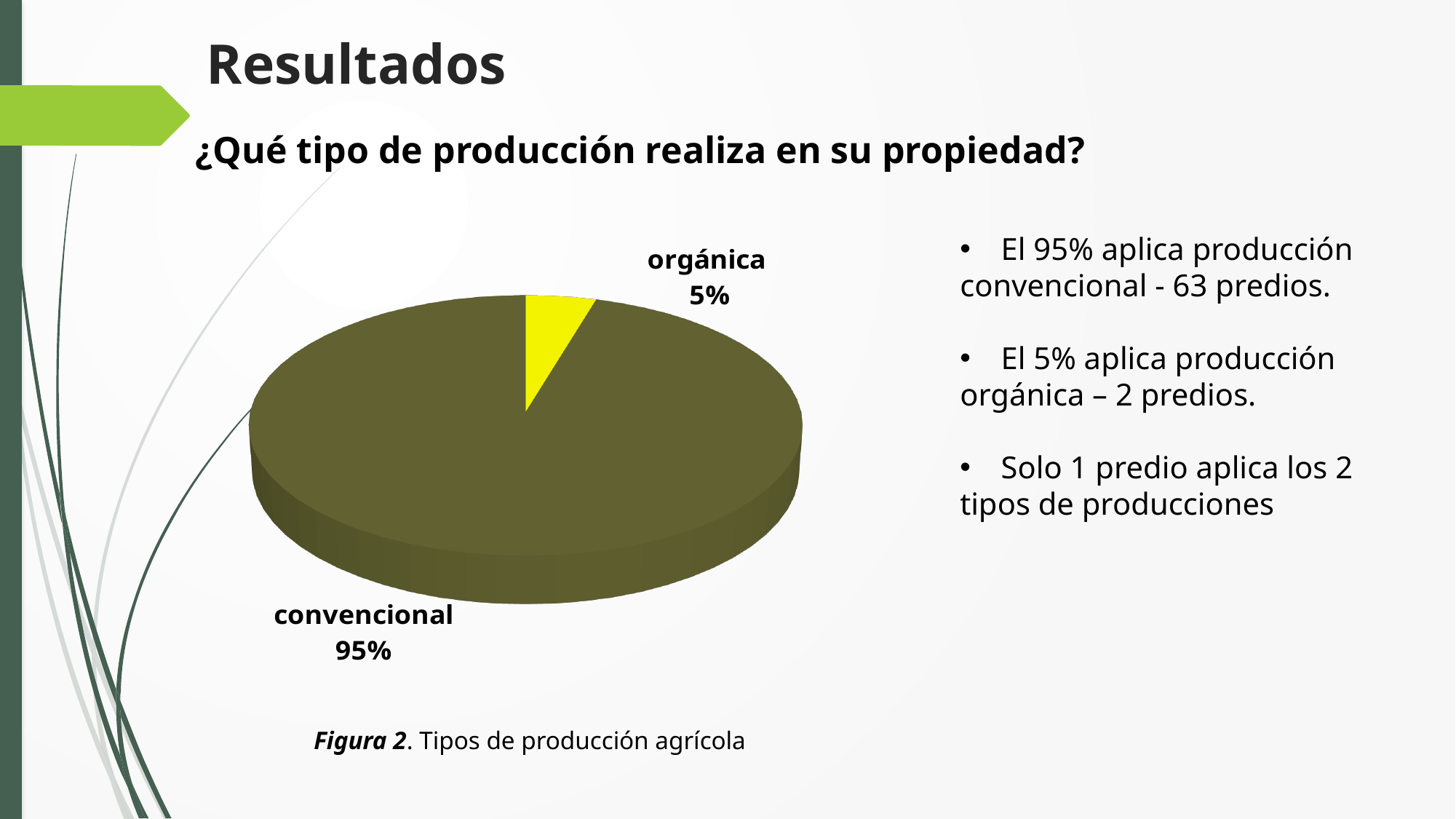
What is the figure caption below the chart? Figura 2. Tipos de producción agrícola What share of the pie does the 'convencional' slice represent? 95% Which category has the largest slice of the pie? convencional How many categories are shown in the pie chart? 2 What is the difference in percentage points between the 'convencional' and 'orgánica' slices? 90 Which is larger, the 'convencional' slice or the 'orgánica' slice? convencional What share of the pie does the 'orgánica' slice represent? 5% Which category has the smallest slice of the pie? orgánica What colour is the 'orgánica' slice? yellow What kind of chart is shown on the slide? pie chart